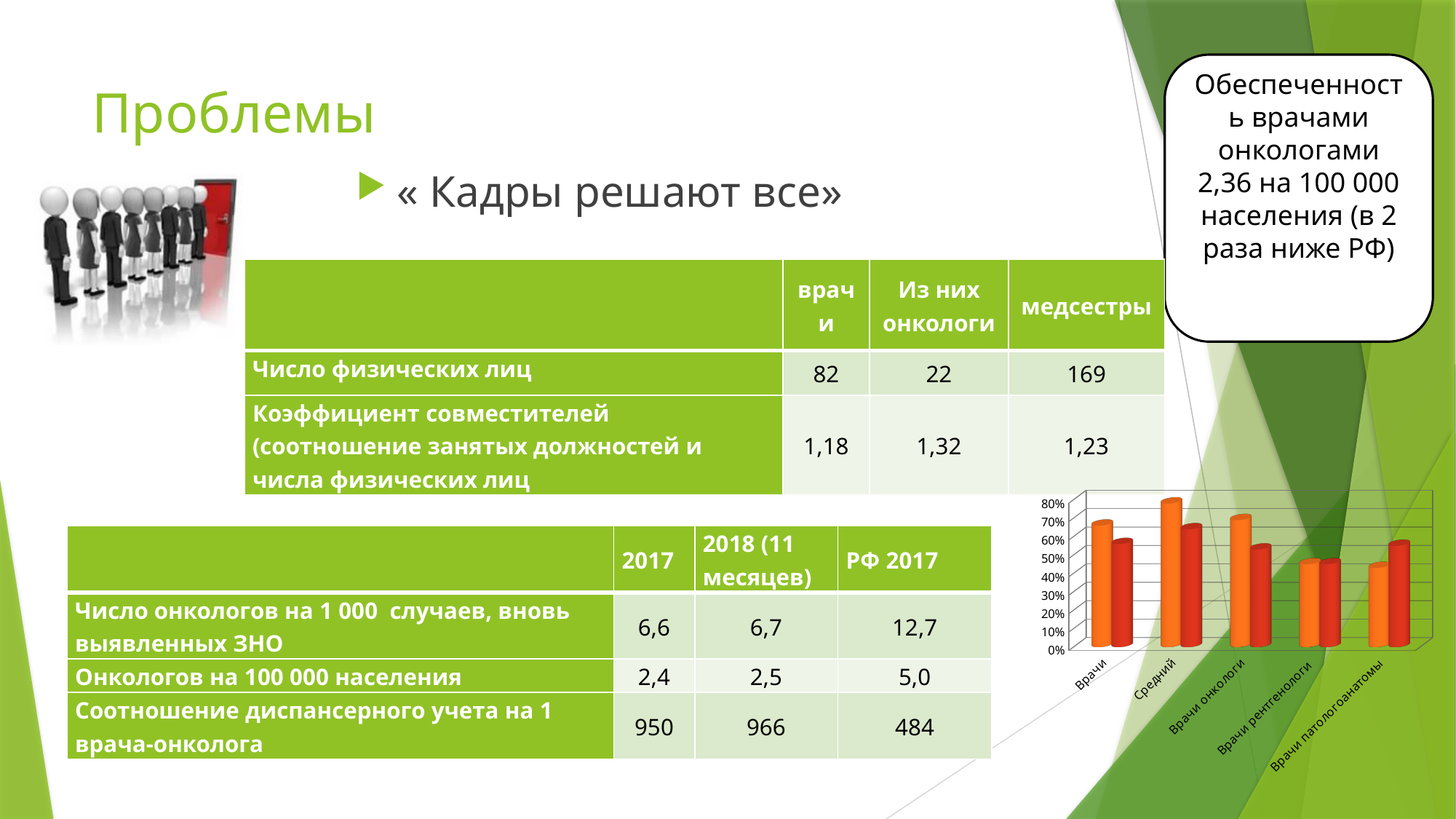
In the bar chart, for the category Врачи, which bar is taller, the orange one or the red one? orange In the bar chart, is the orange bar for Врачи рентгенологи greater or less than 60%? less What kind of chart is shown at the bottom right of the slide? bar chart In the bar chart, is the orange bar for Средний greater or less than 70%? greater In the bar chart, which category has the tallest red bar? Средний In the bar chart, which category has the tallest orange bar? Средний In the bar chart, is the orange bar for Врачи онкологи greater or less than 60%? greater What is the highest value shown on the y axis of the bar chart? 80% In the bar chart, for the category Врачи патологоанатомы, which bar is taller, the orange one or the red one? red How many categories are shown on the x axis of the bar chart? 5 What is the label of the first category on the x axis of the bar chart? Врачи